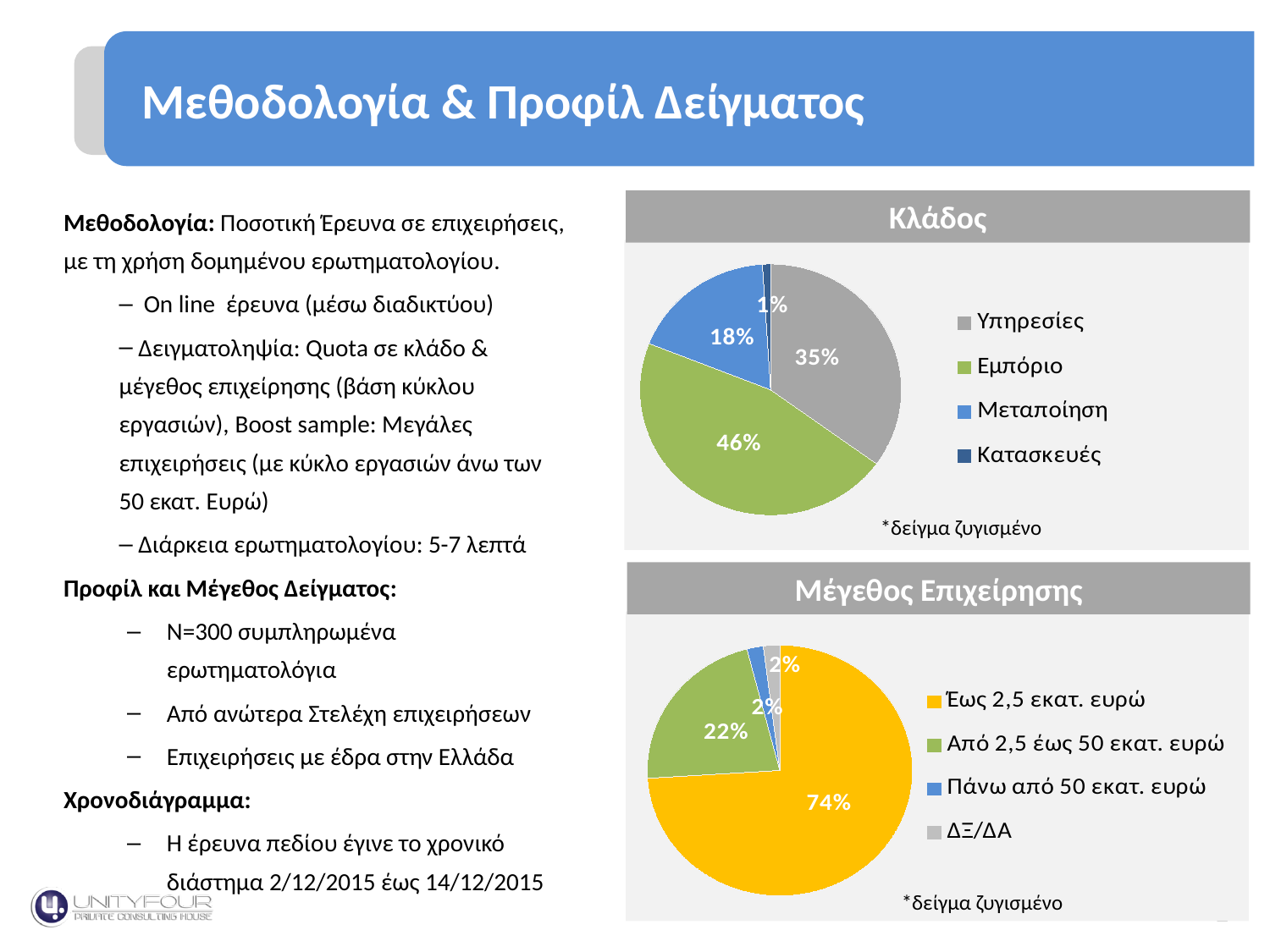
In the "Κλάδος" chart, what share does Υπηρεσίες have? 35% In the "Μέγεθος Επιχείρησης" chart, what share does "Από 2,5 έως 50 εκατ. ευρώ" have? 22% In the "Μέγεθος Επιχείρησης" chart, which category has the largest share? Έως 2,5 εκατ. ευρώ In the "Κλάδος" chart, what is the difference between the shares of Εμπόριο and Μεταποίηση? 28% In the "Κλάδος" chart, which category has the smallest share? Κατασκευές In the "Μέγεθος Επιχείρησης" chart, what share does "Έως 2,5 εκατ. ευρώ" have? 74% In the "Κλάδος" chart, which category has the largest share? Εμπόριο In the "Μέγεθος Επιχείρησης" chart, which is larger: "Από 2,5 έως 50 εκατ. ευρώ" or "Πάνω από 50 εκατ. ευρώ"? Από 2,5 έως 50 εκατ. ευρώ What note appears below both pie charts? *δείγμα ζυγισμένο In the "Κλάδος" chart, how many categories does the legend list? 4 In the "Κλάδος" chart, what share does Εμπόριο have? 46% What type of chart is the "Μέγεθος Επιχείρησης" chart? Pie chart